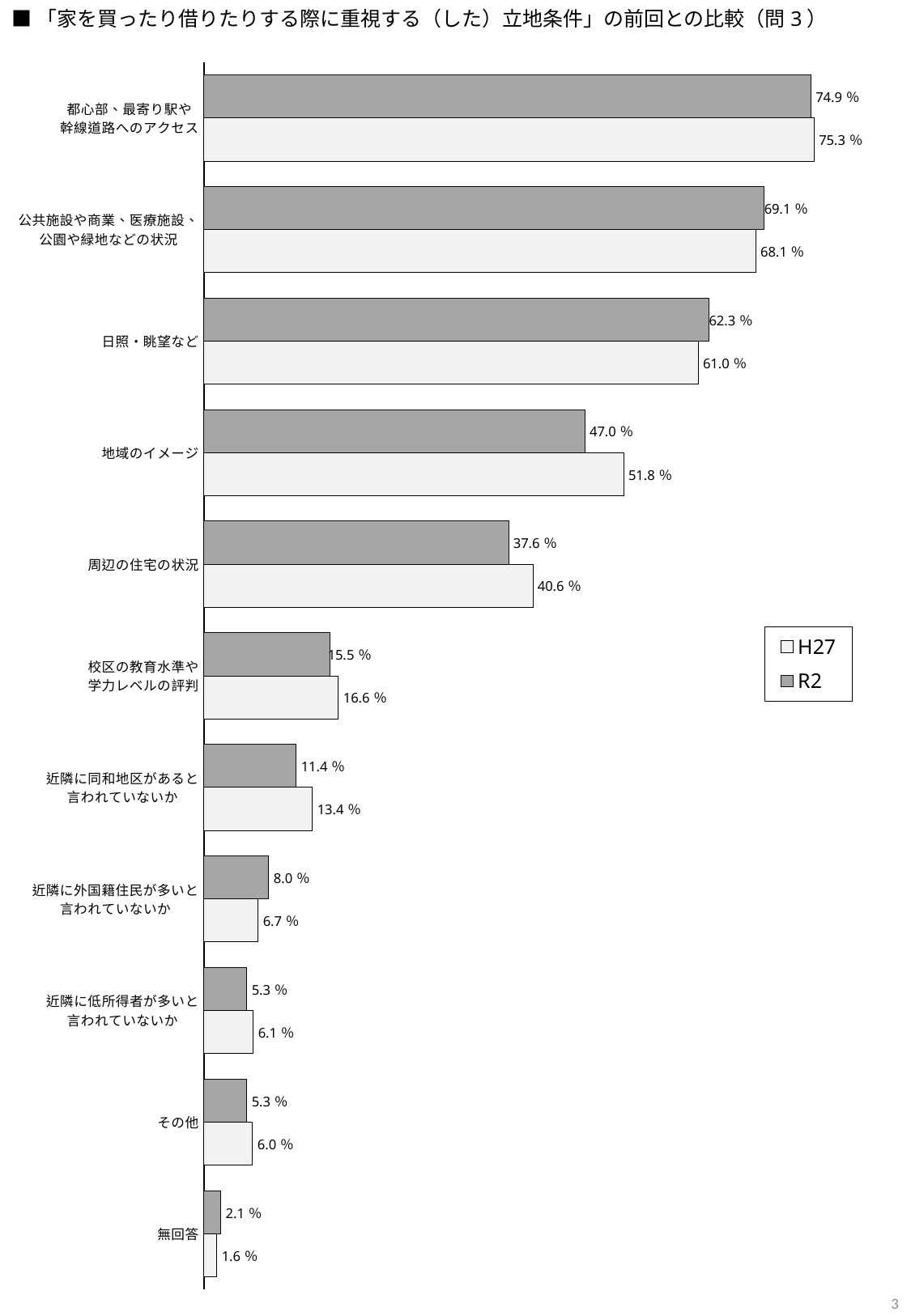
For 近隣に外国籍住民が多いと言われていないか, which is larger, the R2 value or the H27 value? R2 What is the H27 value for 近隣に同和地区があると言われていないか? 13.4 % How many series does the legend list? 2 Which category has the lowest H27 value? 無回答 What is the difference between the H27 and R2 values for 周辺の住宅の状況? 3.0 % What is the difference between the R2 and H27 values for 日照・眺望など? 1.3 % Which category has the highest R2 value? 都心部、最寄り駅や幹線道路へのアクセス How many categories are shown on the chart? 11 What is the R2 value for 都心部、最寄り駅や幹線道路へのアクセス? 74.9 % Which series is drawn with the darker gray bars? R2 What type of chart is shown on the slide? bar chart What is the H27 value for 地域のイメージ? 51.8 %